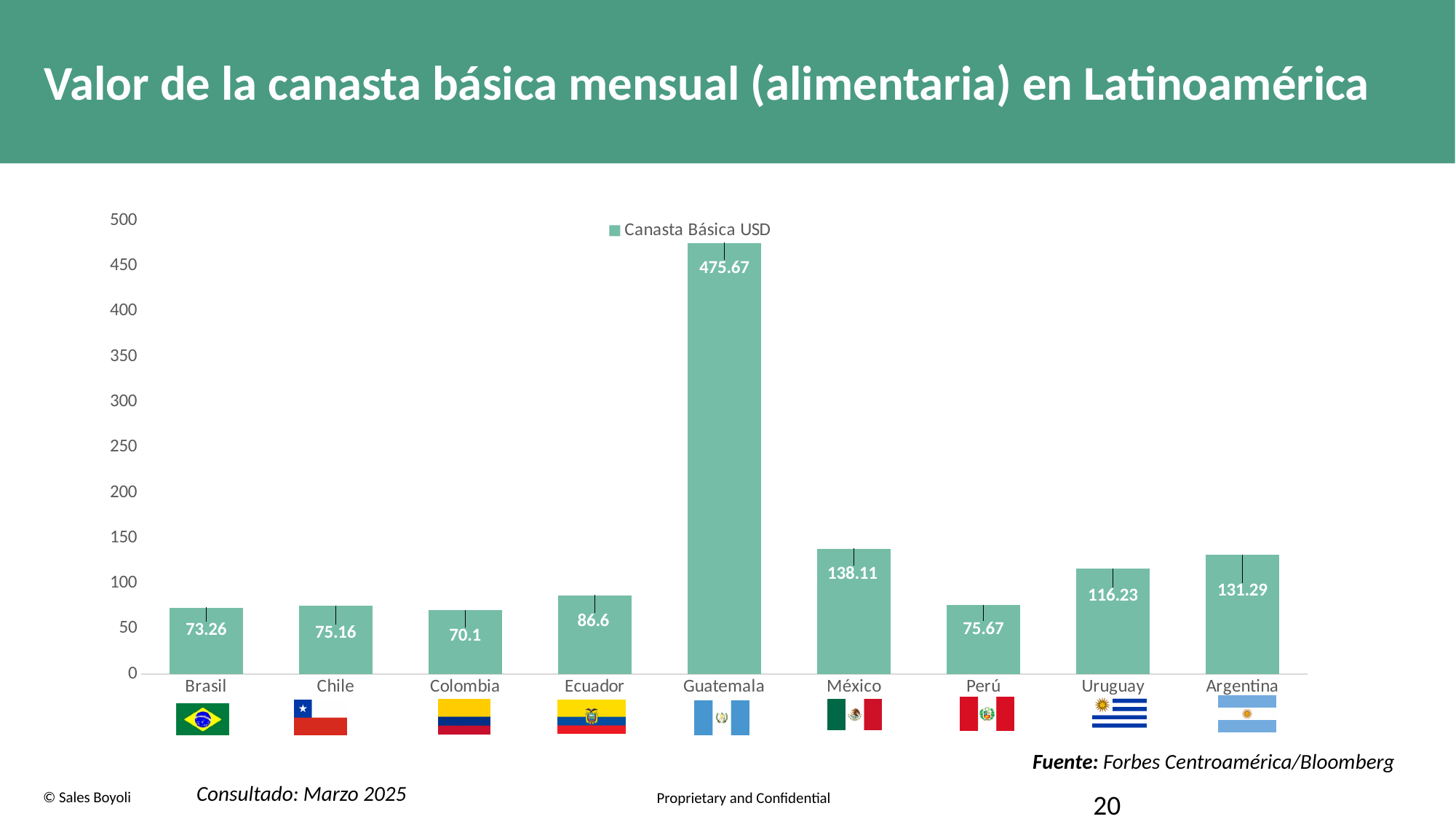
How many countries are shown on the chart? 9 What is the difference between the values for Guatemala and México? 337.56 Which is larger, the value for Ecuador or the value for Perú? Ecuador Which country has the highest value? Guatemala Is the value for Argentina greater or less than 100? greater Which country has the lowest value? Colombia What is the difference between the values for Argentina and Uruguay? 15.06 What is the value for Uruguay? 116.23 What is the value for México? 138.11 What kind of chart is shown on the slide? Bar chart What is the value for Colombia? 70.1 What is the value for Guatemala? 475.67